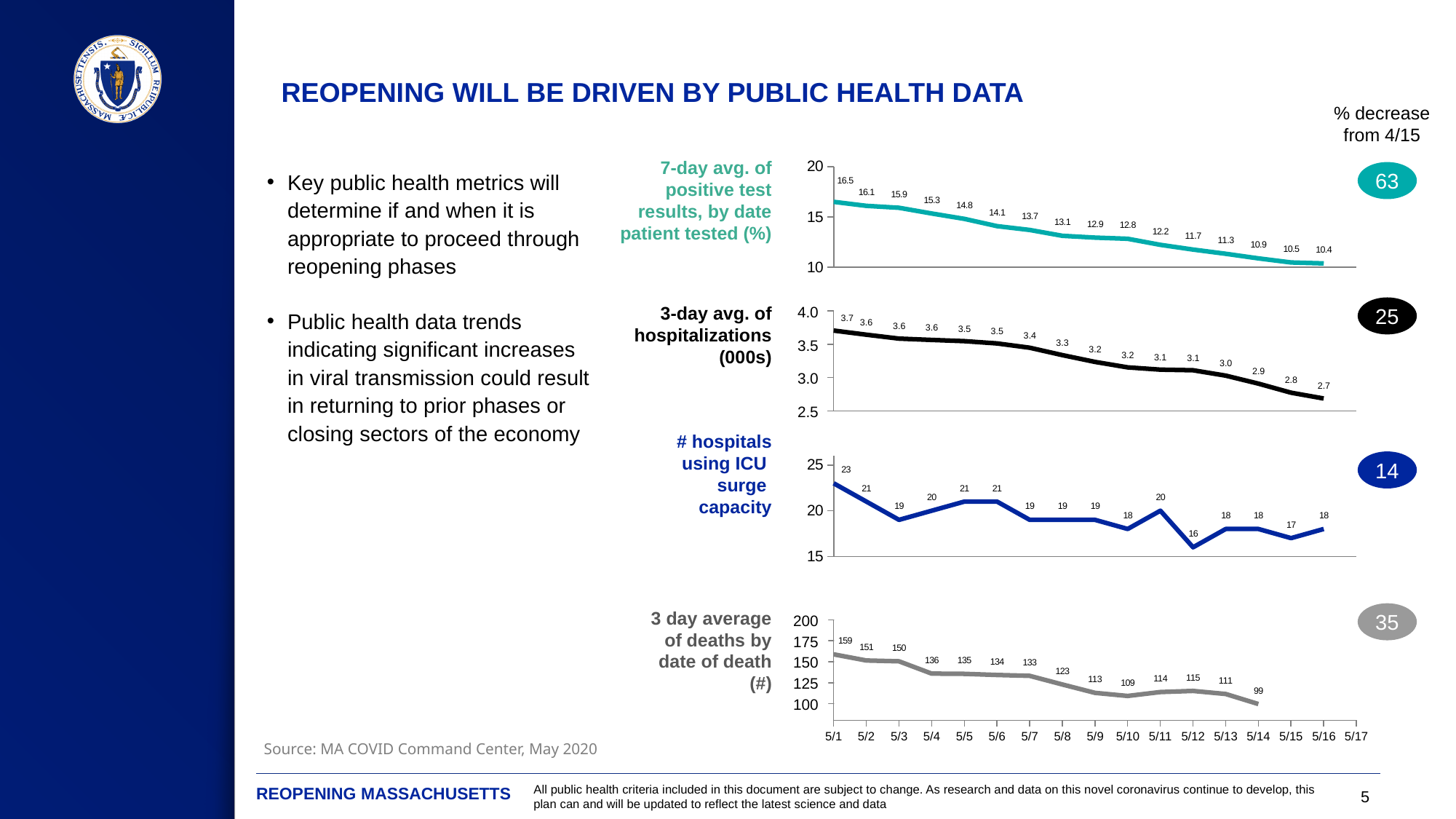
On the '3 day average of deaths by date of death' chart, how many data points are plotted? 14 On the '# hospitals using ICU surge capacity' chart, what is the highest value shown? 23 On the '3 day average of deaths by date of death' chart, what is the difference between the 5/1 value and the 5/14 value? 60 On the '# hospitals using ICU surge capacity' chart, which is larger, the value on 5/1 or the value on 5/12? 5/1 On the '3-day avg. of hospitalizations (000s)' chart, what is the value on 5/16? 2.7 What type of chart is used for the '3-day avg. of hospitalizations (000s)' data? line chart On the '7-day avg. of positive test results' chart, what is the value on 5/16? 10.4 On the '7-day avg. of positive test results' chart, what is the value on 5/1? 16.5 On the '# hospitals using ICU surge capacity' chart, what is the lowest value shown? 16 What '% decrease from 4/15' is shown next to the '7-day avg. of positive test results' chart? 63 On the '3 day average of deaths by date of death' chart, what is the value on 5/14? 99 On the '7-day avg. of positive test results' chart, do the values rise or fall from 5/1 to 5/16? fall